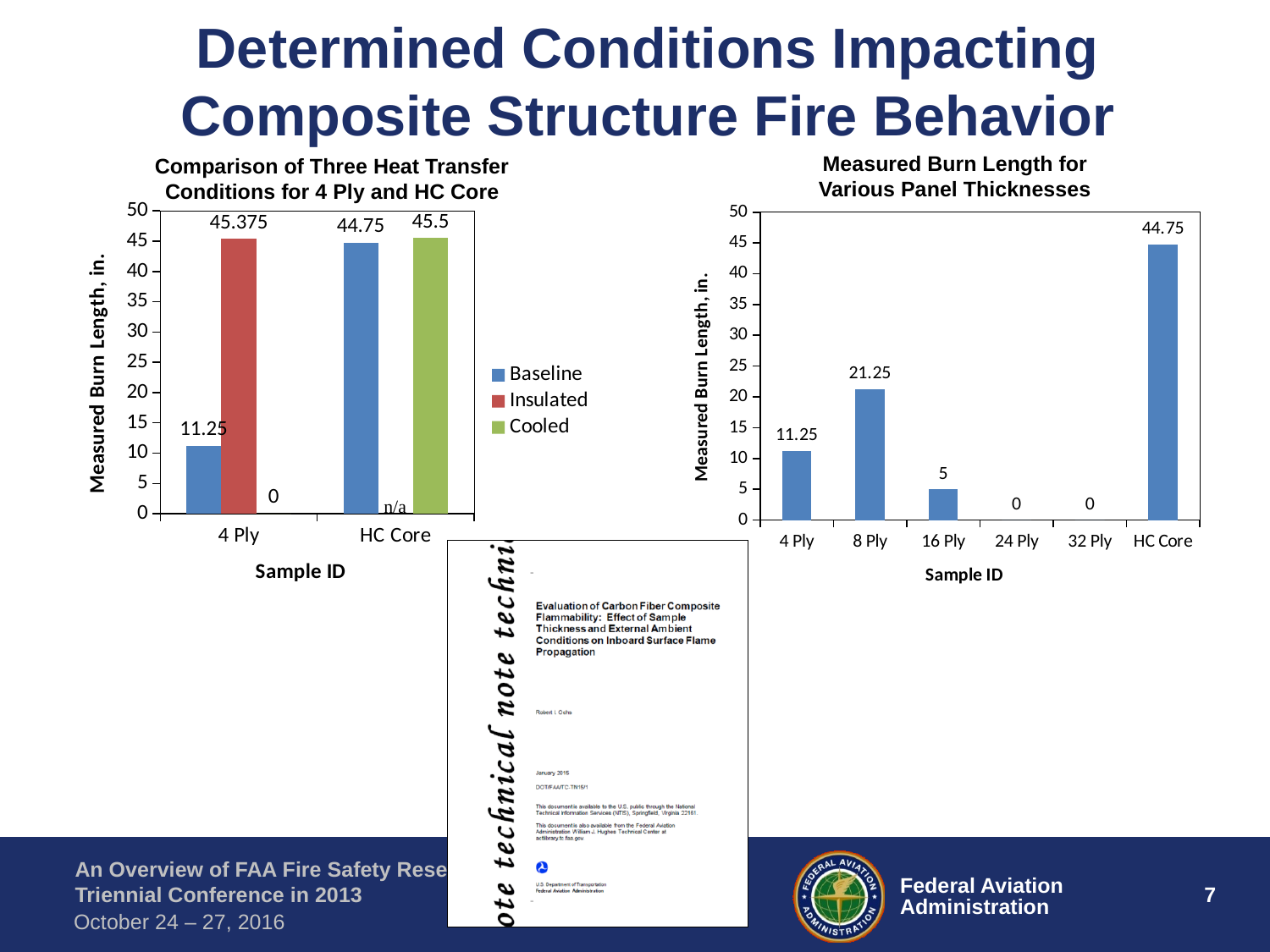
In the 'Measured Burn Length for Various Panel Thicknesses' chart, what is the measured burn length for 8 Ply? 21.25 In the 'Measured Burn Length for Various Panel Thicknesses' chart, what is the value for 16 Ply? 5 What type of chart is the 'Comparison of Three Heat Transfer Conditions for 4 Ply and HC Core' chart? Bar chart In the 'Measured Burn Length for Various Panel Thicknesses' chart, do the values rise or fall from 4 Ply to 32 Ply? They rise from 4 Ply to 8 Ply, then fall to 0 at 24 Ply and 32 Ply In the 'Comparison of Three Heat Transfer Conditions for 4 Ply and HC Core' chart, how many series does the legend list? 3 In the 'Comparison of Three Heat Transfer Conditions for 4 Ply and HC Core' chart, what is the Cooled value for HC Core? 45.5 In the 'Measured Burn Length for Various Panel Thicknesses' chart, what is the difference between the burn lengths for HC Core and 4 Ply? 33.5 In the 'Comparison of Three Heat Transfer Conditions for 4 Ply and HC Core' chart, what is the Insulated value for 4 Ply? 45.375 In the 'Comparison of Three Heat Transfer Conditions for 4 Ply and HC Core' chart, which is larger for 4 Ply: the Baseline value or the Insulated value? Insulated In the 'Measured Burn Length for Various Panel Thicknesses' chart, which sample has the highest measured burn length? HC Core In the 'Measured Burn Length for Various Panel Thicknesses' chart, how many sample IDs are shown on the x axis? 6 In the 'Comparison of Three Heat Transfer Conditions for 4 Ply and HC Core' chart, what is shown for the Insulated condition of HC Core? n/a